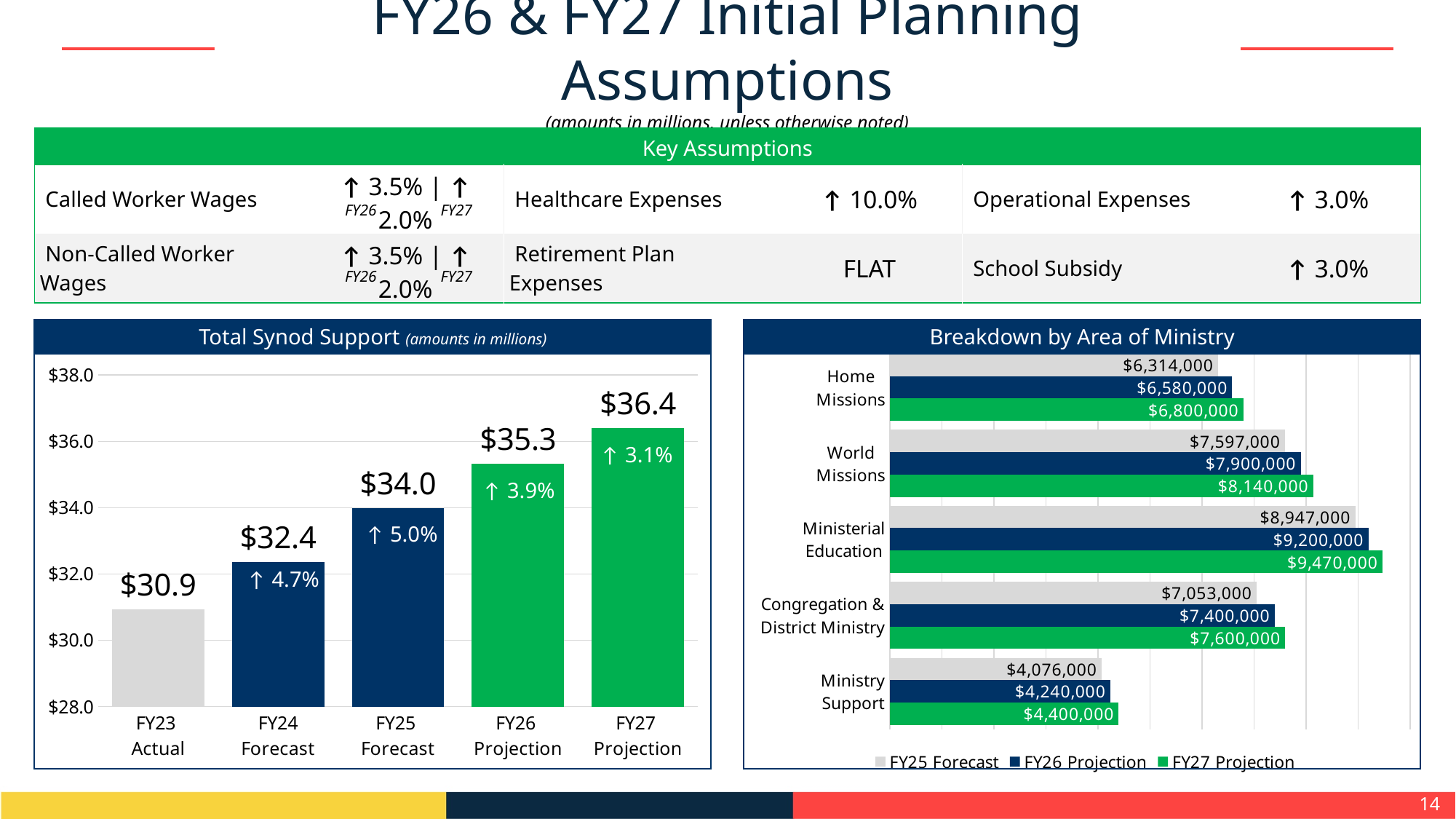
In the Breakdown by Area of Ministry chart, what is the difference between the FY27 Projection and FY25 Forecast for Home Missions? $486,000 In the Breakdown by Area of Ministry chart, which area has the lowest FY25 Forecast value? Ministry Support In the Total Synod Support chart, which category has the lowest value? FY23 Actual In the Total Synod Support chart, what is the difference between FY27 Projection and FY26 Projection? $1.1 In the Total Synod Support chart, how many bars are plotted? 5 In the Breakdown by Area of Ministry chart, which is larger: the FY26 Projection for Congregation & District Ministry or the FY26 Projection for Home Missions? Congregation & District Ministry What kind of chart is the Total Synod Support chart? bar chart In the Breakdown by Area of Ministry chart, how many series does the legend list? 3 In the Total Synod Support chart, do the values rise or fall from FY23 Actual to FY27 Projection? rise In the Breakdown by Area of Ministry chart, which area has the highest FY27 Projection value? Ministerial Education In the Total Synod Support chart, what is the value for FY25 Forecast? $34.0 In the Breakdown by Area of Ministry chart, what is the FY26 Projection value for World Missions? $7,900,000